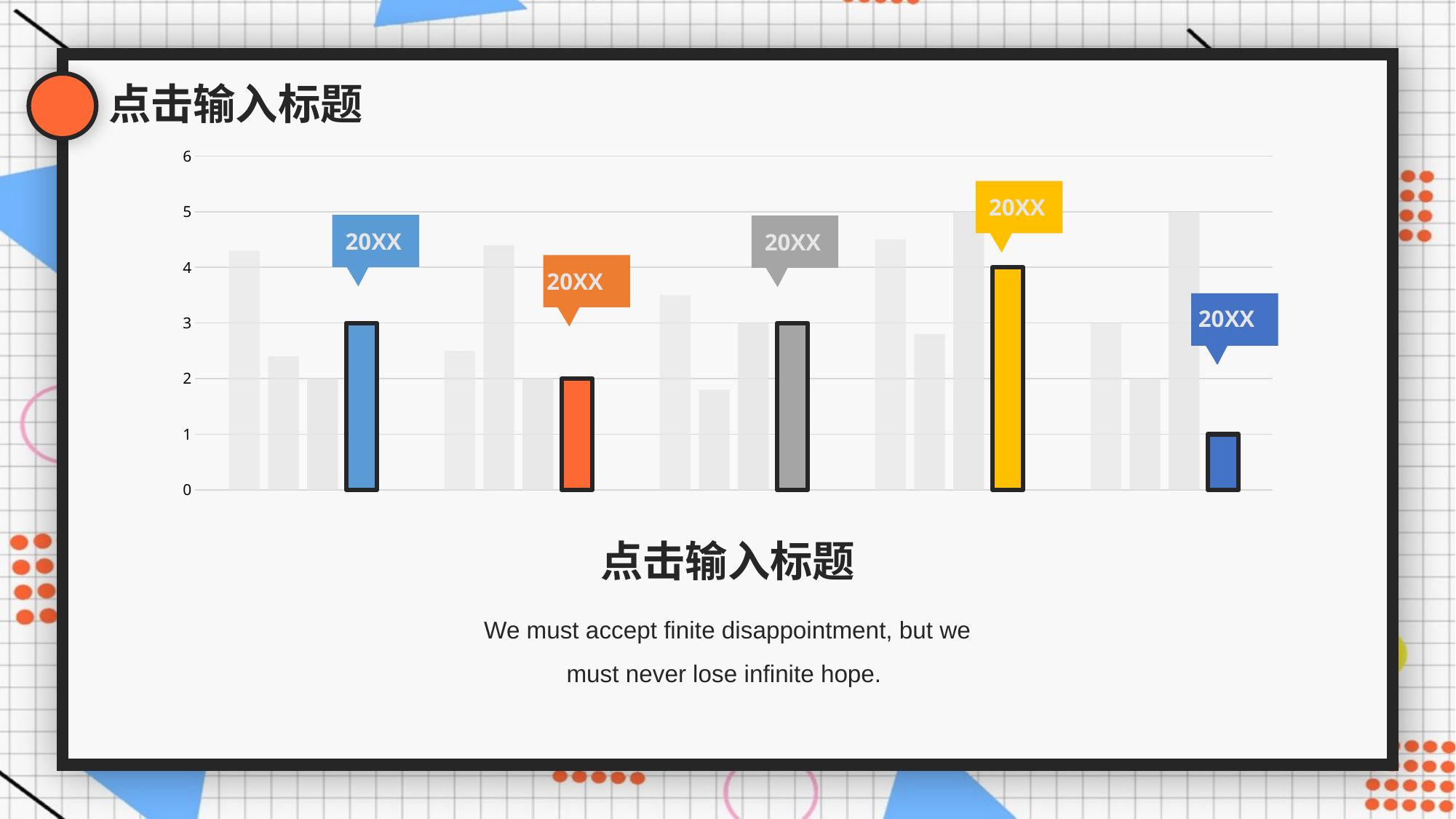
What text appears in each of the callout labels above the highlighted bars? 20XX What is the value of the dark blue highlighted bar (the rightmost coloured bar)? 1 What is the difference between the yellow highlighted bar and the orange highlighted bar? 2 Which of the five coloured highlighted bars is the shortest? the dark blue bar How many coloured highlighted bars with callout labels are there in the chart? 5 Which is larger, the light blue highlighted bar or the orange highlighted bar? the light blue bar What is the value of the light blue highlighted bar (the first coloured bar from the left)? 3 Is the value of the grey highlighted bar (with the grey callout) greater or less than 2? greater What kind of chart is shown on the slide? bar chart Which of the five coloured highlighted bars is the tallest? the yellow bar What is the value of the orange highlighted bar? 2 What is the value of the yellow highlighted bar? 4